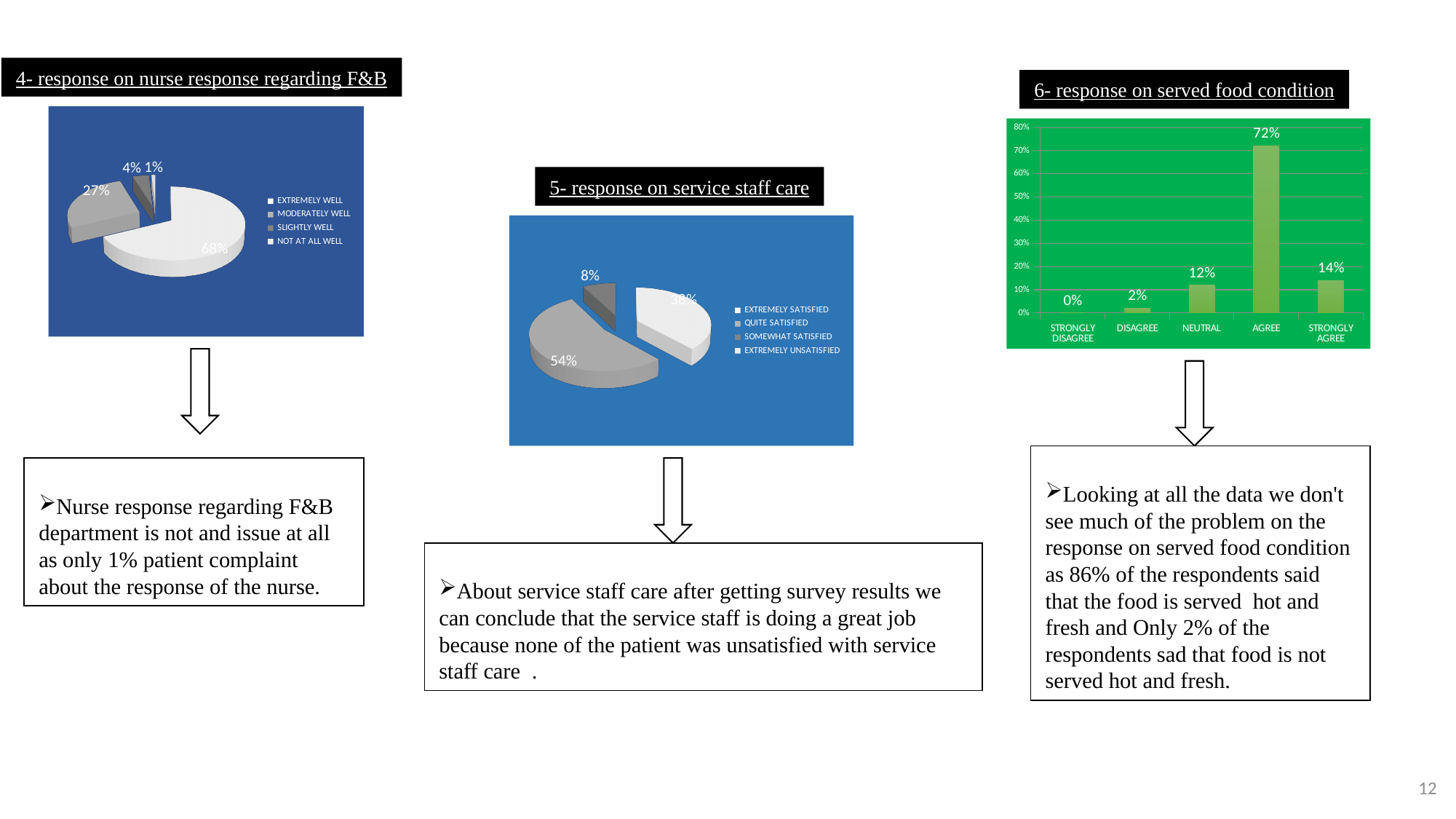
In the chart titled '5- response on service staff care', which is larger, QUITE SATISFIED or SOMEWHAT SATISFIED? QUITE SATISFIED In the chart titled '6- response on served food condition', which category has the lowest value? STRONGLY DISAGREE In the chart titled '5- response on service staff care', what share of the pie is QUITE SATISFIED? 54% In the chart titled '6- response on served food condition', what is the value for AGREE? 72% In the chart titled '4- response on nurse response regarding F&B', what share of the pie is MODERATELY WELL? 27% In the chart titled '6- response on served food condition', which category has the highest value? AGREE In the chart titled '4- response on nurse response regarding F&B', what share of the pie is NOT AT ALL WELL? 1% In the chart titled '6- response on served food condition', how many categories are shown on the x axis? 5 In the chart titled '6- response on served food condition', what is the value for NEUTRAL? 12% In the chart titled '4- response on nurse response regarding F&B', how many entries does the legend list? 4 What kind of chart is the one titled '6- response on served food condition'? Bar chart In the chart titled '6- response on served food condition', what is the difference between the values for AGREE and STRONGLY AGREE? 58%